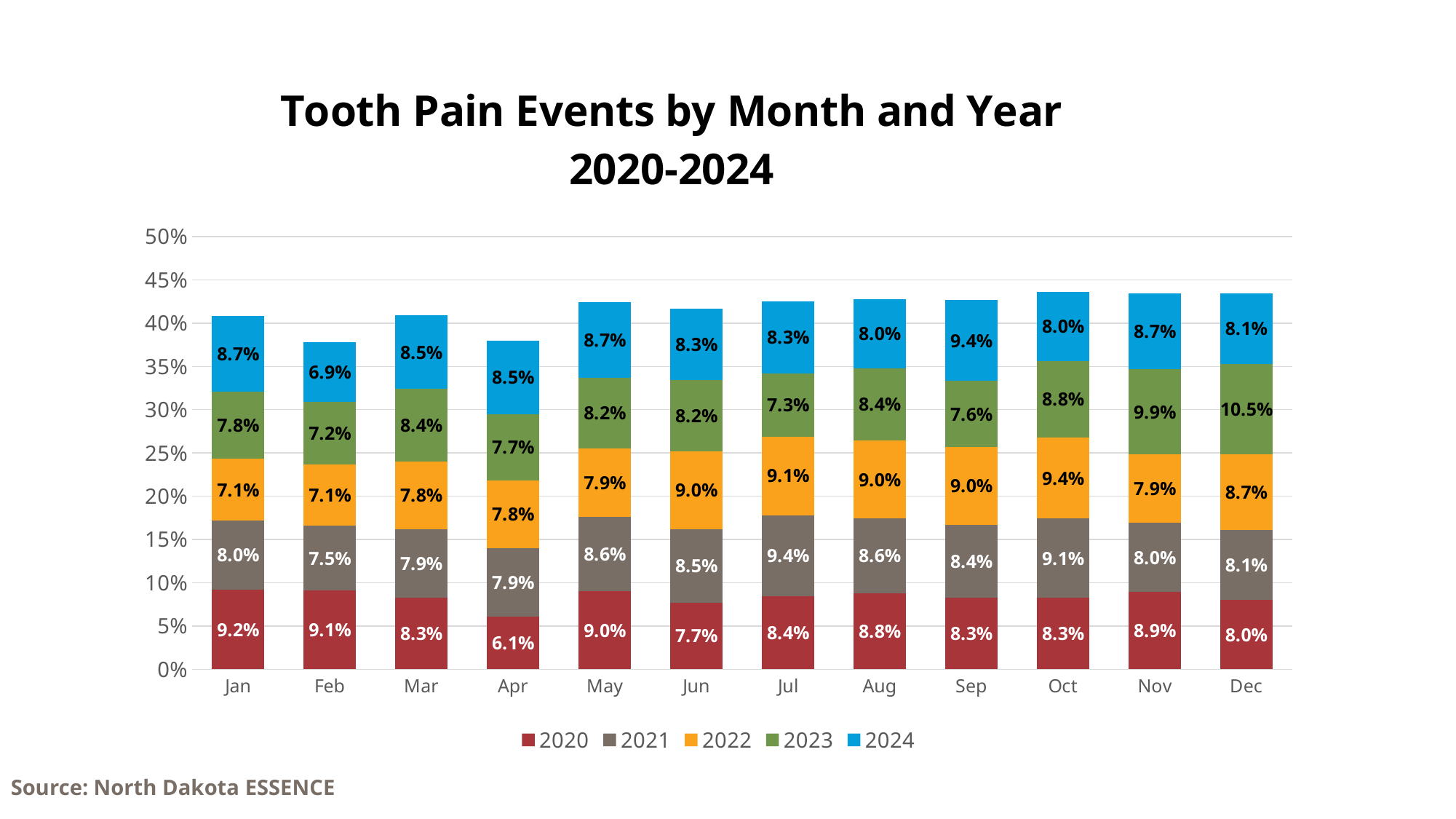
What type of chart is shown on the slide? Stacked bar chart Is the total of the stacked bar for October greater or less than 40%? greater What is the value for 2023 in December? 10.5% Which is larger, the 2022 value for October or the 2022 value for November? October In which month is the 2023 value highest? Dec What is the value for 2020 in April? 6.1% How many series does the legend list? 5 What is the difference between the 2023 values for December and January? 2.7% What is the total of the stacked bar for February? 37.8% How many months are shown on the x axis? 12 In which month is the 2020 value lowest? Apr What is the value for 2024 in September? 9.4%